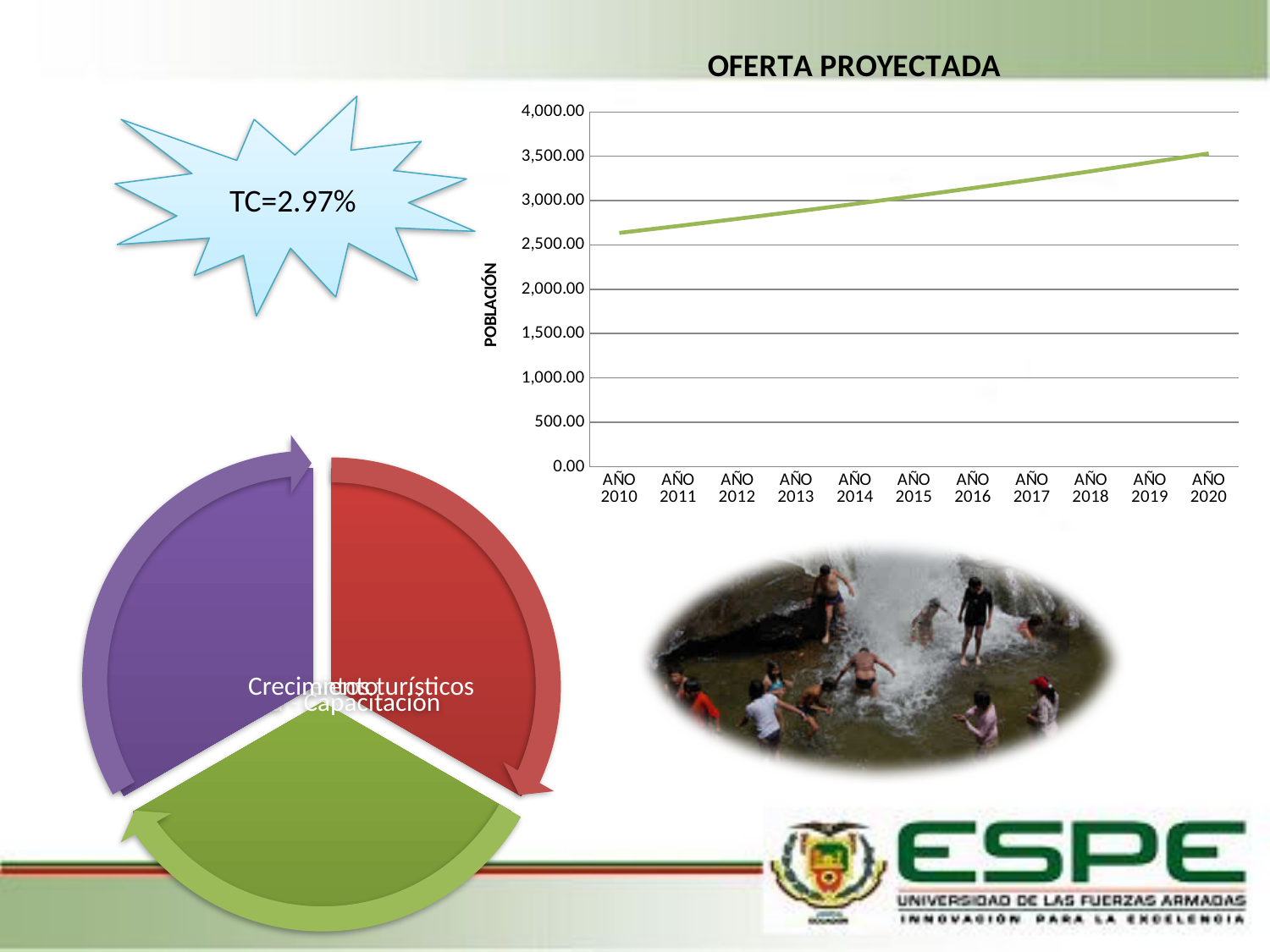
In the OFERTA PROYECTADA chart, is the value for AÑO 2010 greater or less than 3,000.00? less In the OFERTA PROYECTADA chart, is the value for AÑO 2010 greater or less than 2,500.00? greater What is the title of the line chart on the slide? OFERTA PROYECTADA In the OFERTA PROYECTADA chart, which year has the lowest value? AÑO 2010 What is the label on the vertical axis of the OFERTA PROYECTADA chart? POBLACIÓN How many years are plotted along the x axis of the OFERTA PROYECTADA chart? 11 In the OFERTA PROYECTADA chart, do the values rise or fall from AÑO 2010 to AÑO 2020? rise In the OFERTA PROYECTADA chart, which year has the highest value? AÑO 2020 What kind of chart is shown under the title OFERTA PROYECTADA? line chart In the OFERTA PROYECTADA chart, is the value for AÑO 2020 greater or less than 3,000.00? greater In the OFERTA PROYECTADA chart, which is larger, the value for AÑO 2012 or the value for AÑO 2018? AÑO 2018